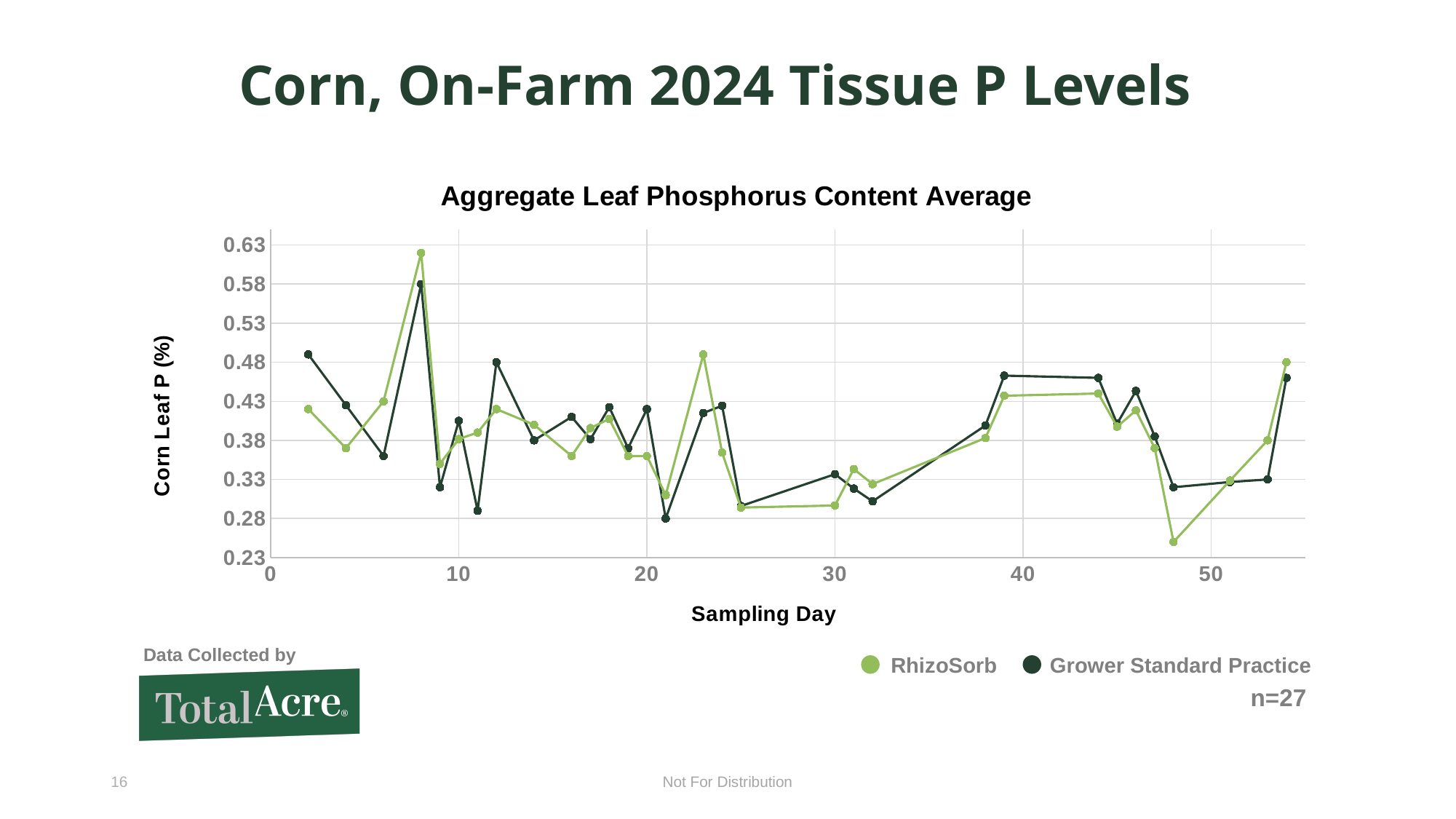
On sampling day 23, which series has the higher value, RhizoSorb or Grower Standard Practice? RhizoSorb What are the two series named in the legend? RhizoSorb and Grower Standard Practice Is the Grower Standard Practice value on sampling day 39 greater or less than 0.43? greater What is the title of the chart? Aggregate Leaf Phosphorus Content Average Is the RhizoSorb value on sampling day 8 greater or less than 0.58? greater Is the RhizoSorb value on sampling day 48 greater or less than 0.28? less On which sampling day does the RhizoSorb series reach its highest value? 8 On which sampling day does the RhizoSorb series reach its lowest value? 48 What kind of chart is shown on the slide? line chart How many series does the legend list? 2 On sampling day 12, which series has the higher value, RhizoSorb or Grower Standard Practice? Grower Standard Practice On which sampling day does the Grower Standard Practice series reach its highest value? 8